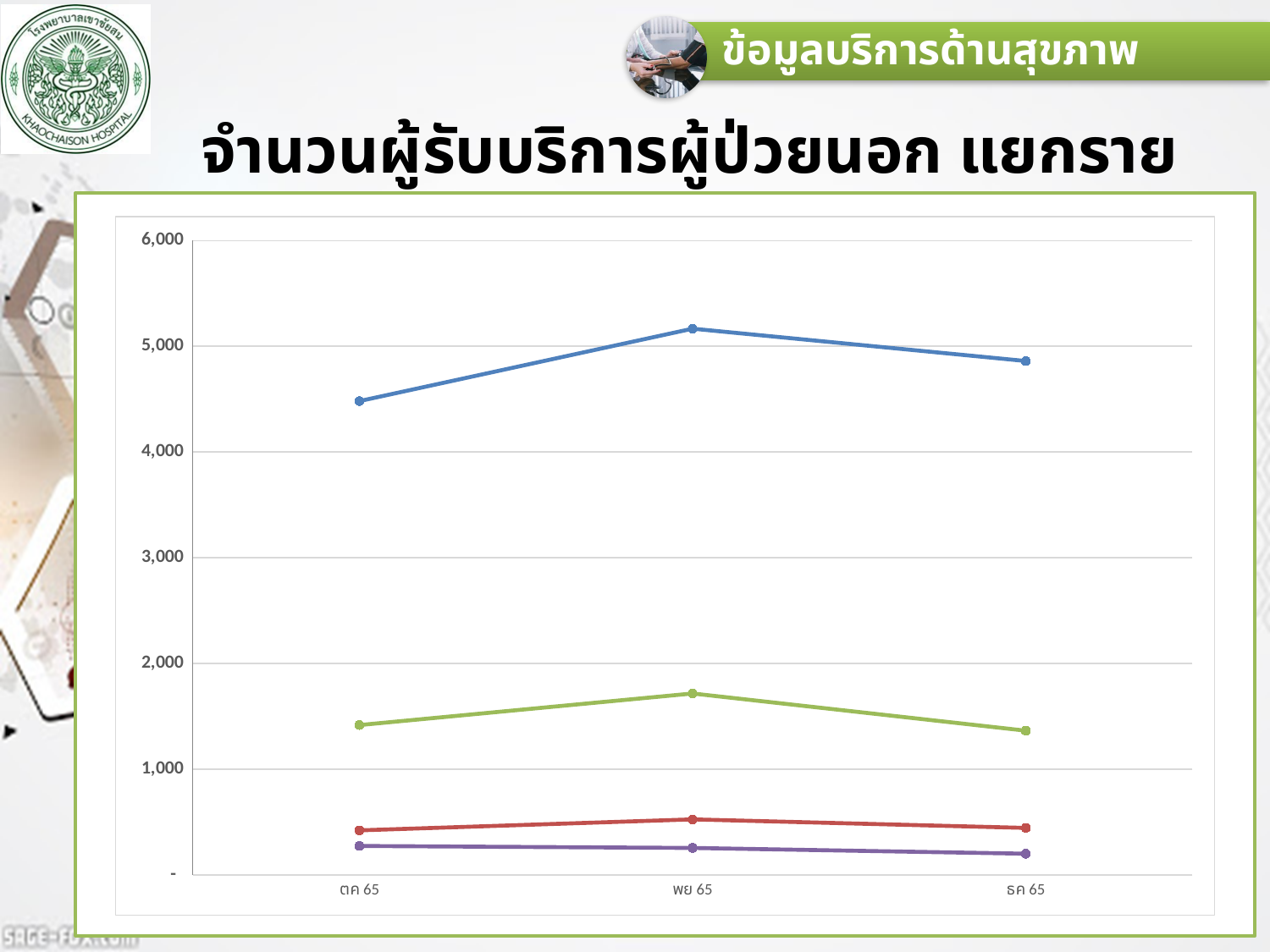
How many categories are shown on the x axis of the chart? 3 Is the value of the green line at พย 65 greater or less than 2,000? less At which x-axis category does the blue line reach its highest value? พย 65 At which x-axis category does the blue line have its lowest value? ตค 65 What kind of chart is shown on the slide? line chart Does the blue line rise or fall from พย 65 to ธค 65? fall Is the value of the blue line at พย 65 greater or less than 5,000? greater Is the value of the blue line at ตค 65 greater or less than 5,000? less Which line has the highest values across all three months? the blue line How many lines are plotted on the chart? 4